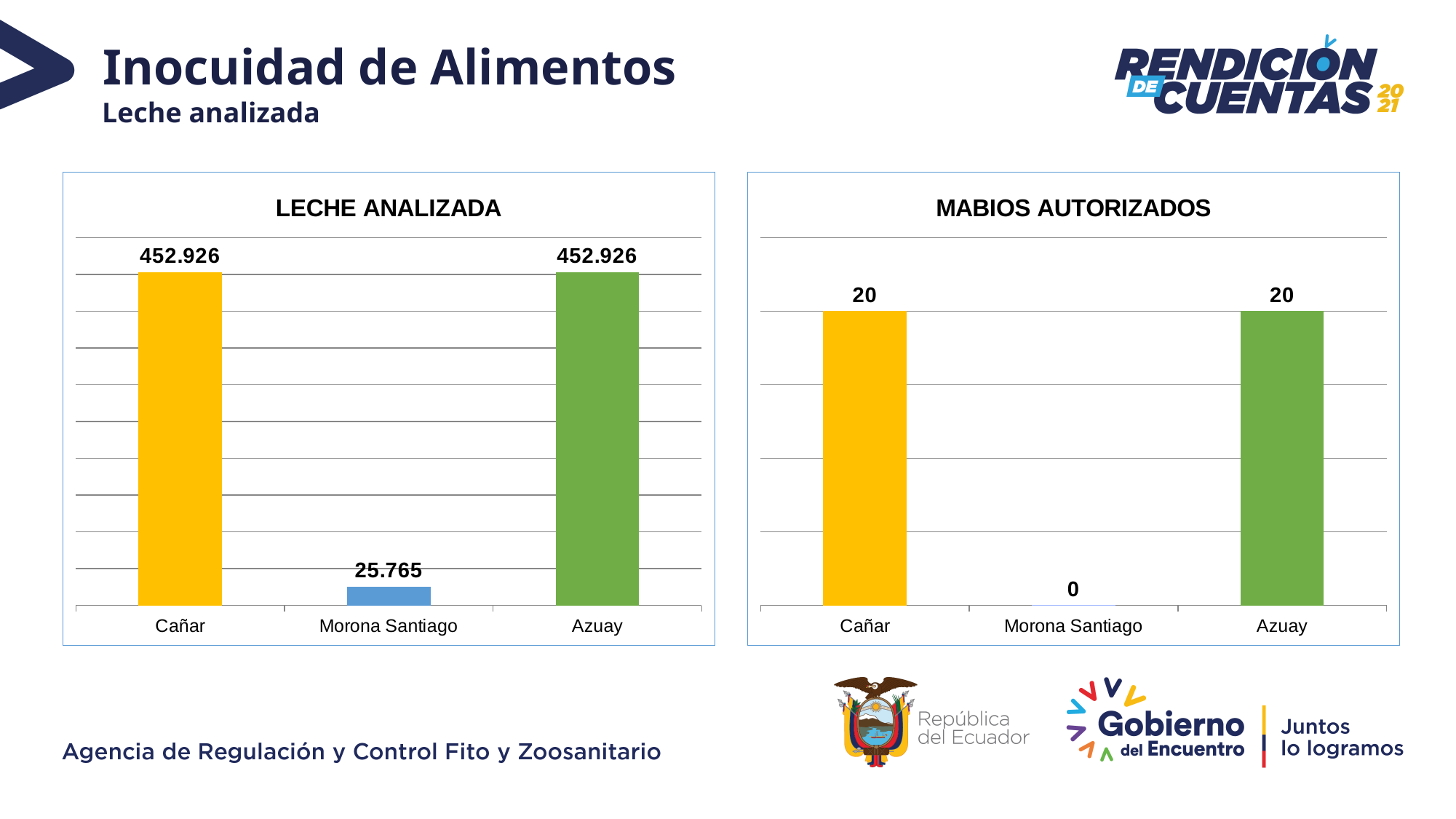
In the LECHE ANALIZADA chart, what is the value for Cañar? 452.926 In the MABIOS AUTORIZADOS chart, which province has the lowest value? Morona Santiago In the MABIOS AUTORIZADOS chart, what is the value for Morona Santiago? 0 In the LECHE ANALIZADA chart, what is the value for Morona Santiago? 25.765 In the LECHE ANALIZADA chart, what is the value for Azuay? 452.926 How many categories are shown in the MABIOS AUTORIZADOS chart? 3 What type of chart is the LECHE ANALIZADA chart? Bar chart In the MABIOS AUTORIZADOS chart, what is the value for Cañar? 20 In the LECHE ANALIZADA chart, what is the difference between the values for Cañar and Morona Santiago? 427.161 In the LECHE ANALIZADA chart, which province has the lowest value? Morona Santiago In the MABIOS AUTORIZADOS chart, what is the difference between the values for Azuay and Morona Santiago? 20 In the LECHE ANALIZADA chart, which is larger, the value for Azuay or the value for Morona Santiago? Azuay